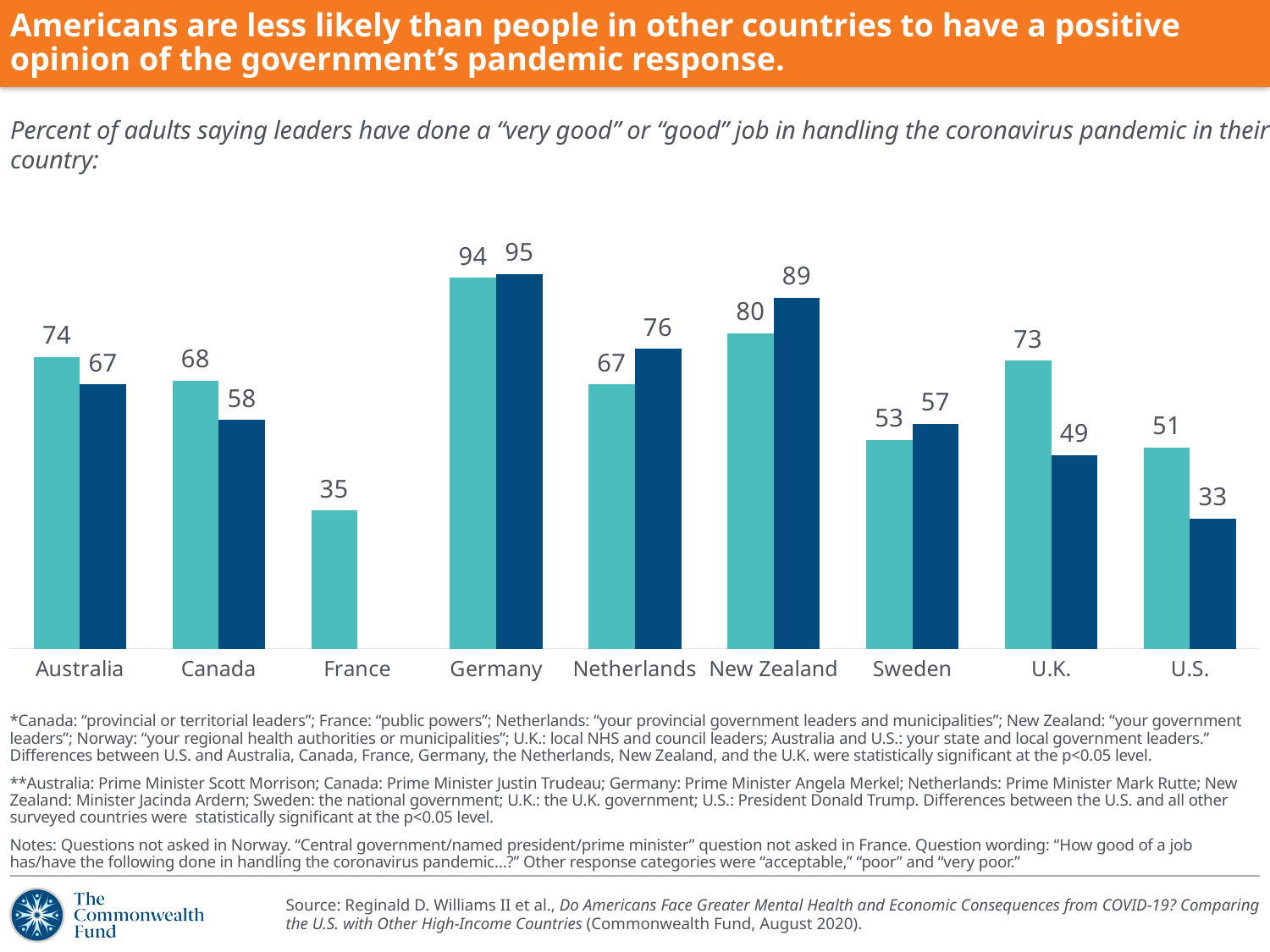
What is the value of the dark blue (right) bar for the U.S.? 33 What is the difference between the light teal and dark blue bars for the U.K.? 24 What kind of chart is shown on the slide? Bar chart What is the value of the dark blue (right) bar for New Zealand? 89 Which country has the lowest light teal (left) bar? France What is the value shown for France? 35 How many countries are shown on the x axis of the chart? 9 Which is larger for the Netherlands, the light teal (left) bar or the dark blue (right) bar? The dark blue (right) bar What is the value of the light teal (left) bar for Germany? 94 What is the difference between the light teal bar for Australia and the light teal bar for the U.S.? 23 Which country is listed last on the x axis of the chart? U.S. Which country has the highest dark blue (right) bar? Germany